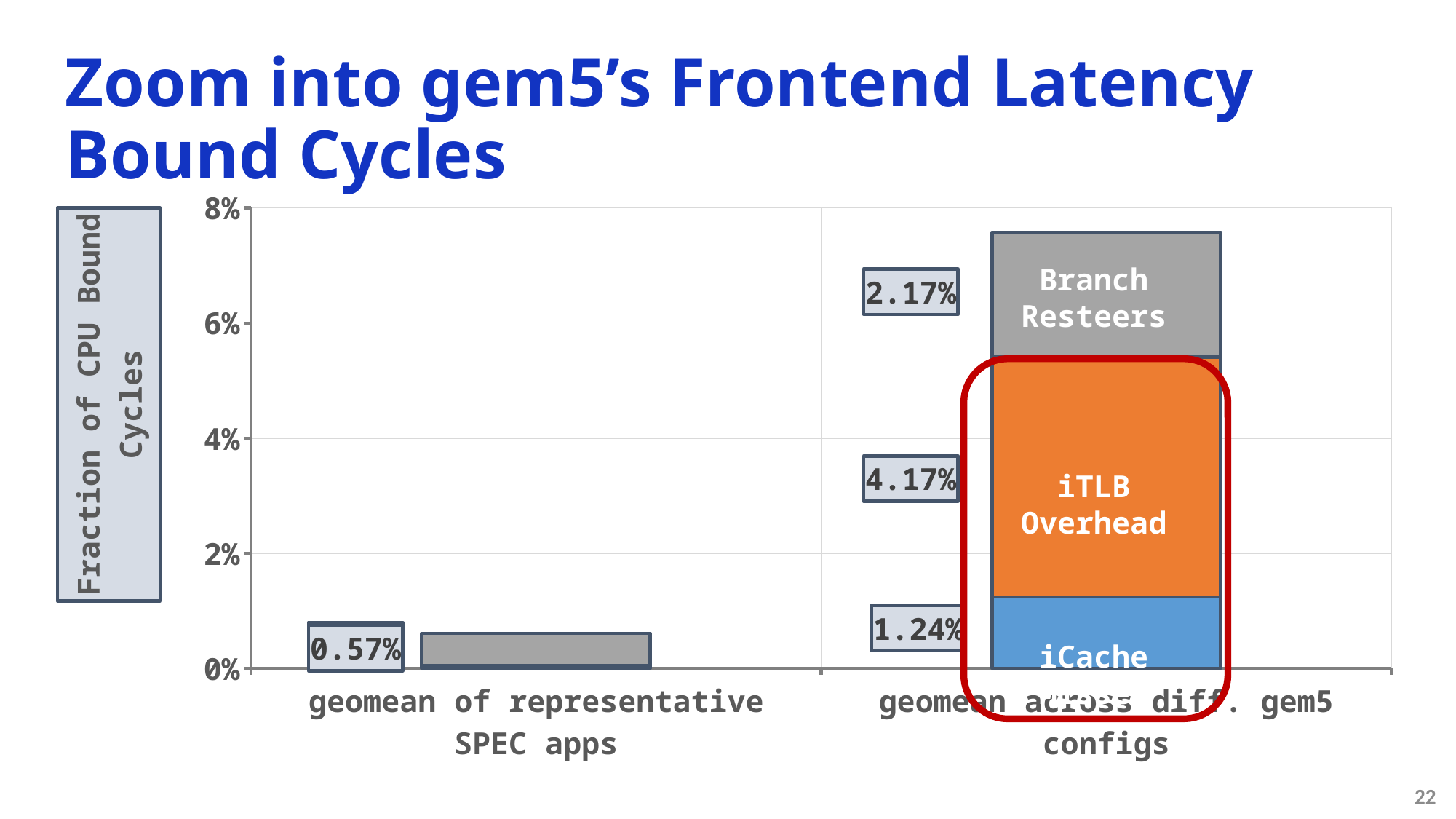
Is the total for the geomean across diff. gem5 configs greater or less than 6%? greater What is the total of the stacked bar for the geomean across diff. gem5 configs? 7.58% What is the iTLB Overhead value for the geomean across diff. gem5 configs? 4.17% What is the label of the y axis? Fraction of CPU Bound Cycles What is the iCache value for the geomean across diff. gem5 configs? 1.24% Which is larger: the iCache value for gem5 configs or the value for representative SPEC apps? iCache value for gem5 configs What is the value for the geomean of representative SPEC apps? 0.57% What is the difference between the iTLB Overhead and Branch Resteers values in the gem5 configs bar? 2.00% Which segment of the geomean across diff. gem5 configs bar is the largest? iTLB Overhead How many categories are shown on the x axis? 2 Which segment of the geomean across diff. gem5 configs bar is the smallest? iCache What is the Branch Resteers value for the geomean across diff. gem5 configs? 2.17%